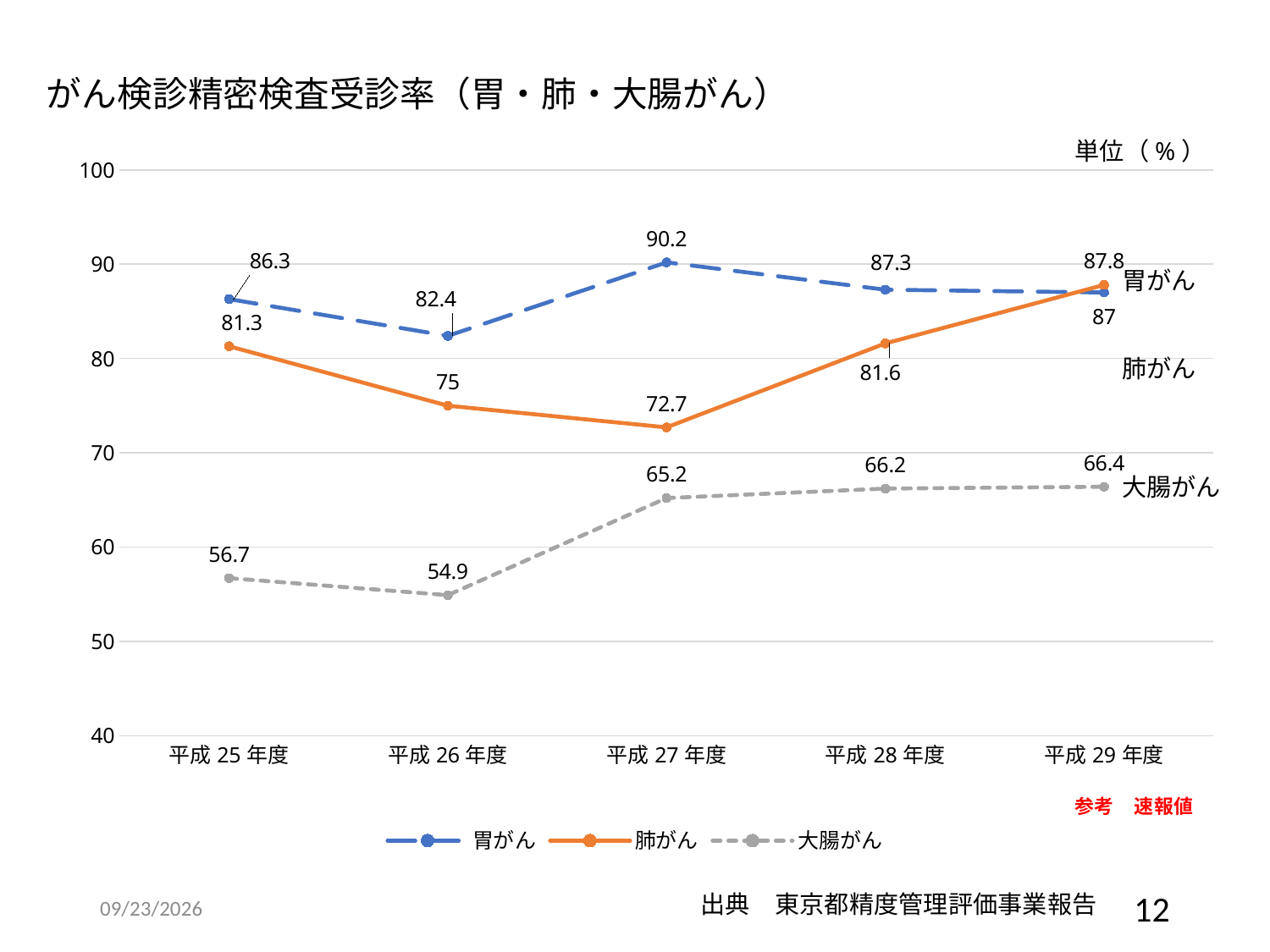
What unit is indicated for the values in the chart? % What is the difference between the 胃がん and 肺がん values in 平成27年度? 17.5 How many fiscal years are plotted on the x axis? 5 Which is larger in 平成29年度, the value for 胃がん or the value for 肺がん? 肺がん In which fiscal year is the value for 胃がん highest? 平成27年度 How many series does the legend list? 3 What is the value for 胃がん in 平成27年度? 90.2 In which fiscal year is the value for 肺がん lowest? 平成27年度 What type of chart is shown on the slide? line chart What is the value for 肺がん in 平成26年度? 75 Does the value for 大腸がん rise or fall from 平成26年度 to 平成29年度? rise What is the value for 大腸がん in 平成25年度? 56.7